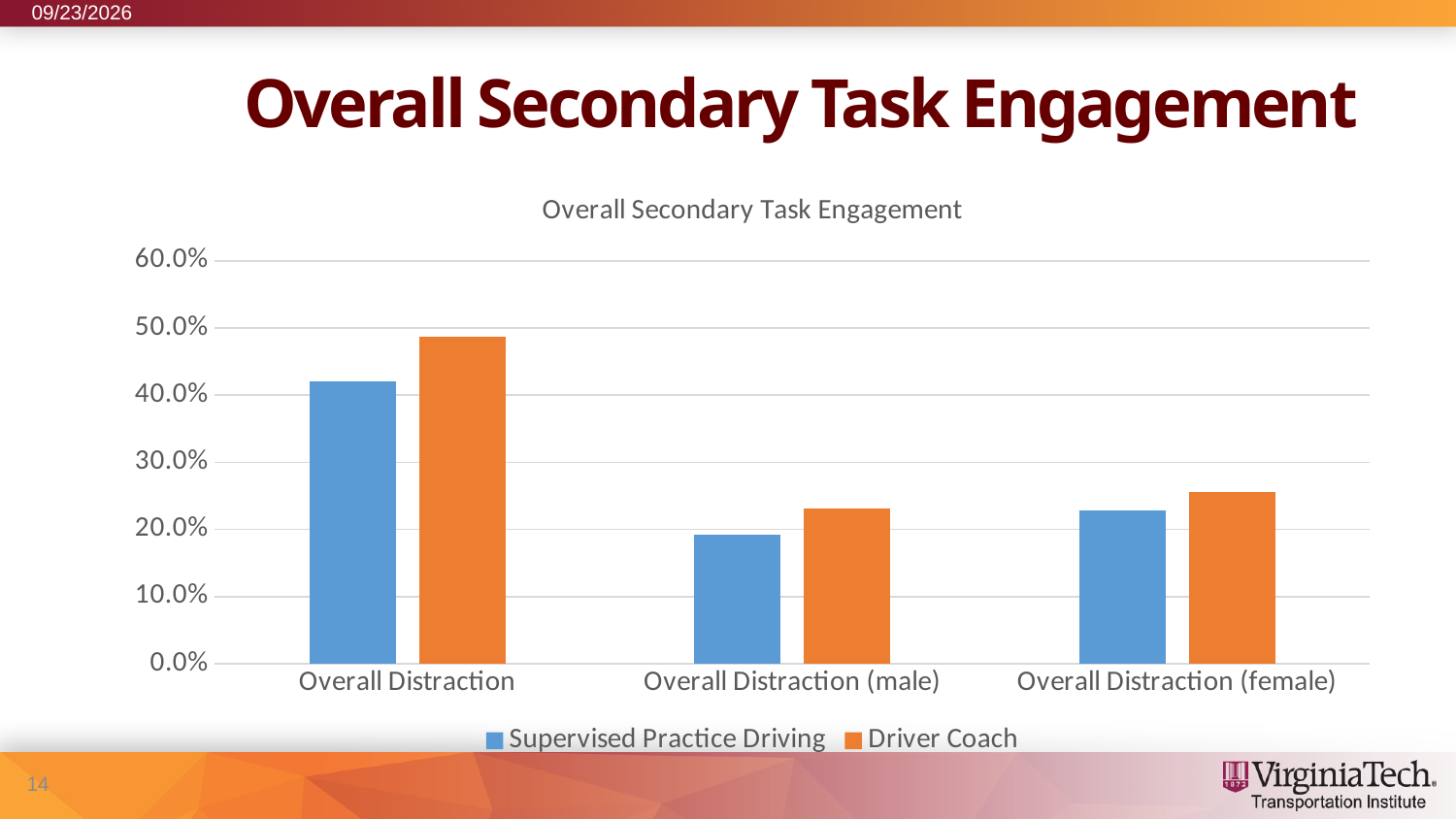
Which series is shown in orange in the chart's legend? Driver Coach How many series does the chart's legend list? 2 How many categories are shown on the x axis of the chart? 3 Which category has the highest Driver Coach value? Overall Distraction Which category has the lowest Supervised Practice Driving value? Overall Distraction (male) For Overall Distraction (male), which series has the larger value: Supervised Practice Driving or Driver Coach? Driver Coach Is the Driver Coach value for Overall Distraction greater or less than 40.0%? greater Is the Supervised Practice Driving value for Overall Distraction (male) greater or less than 30.0%? less Is the Supervised Practice Driving value for Overall Distraction greater or less than 30.0%? greater What kind of chart is shown on the slide? Bar chart For Overall Distraction, which series has the larger value: Supervised Practice Driving or Driver Coach? Driver Coach